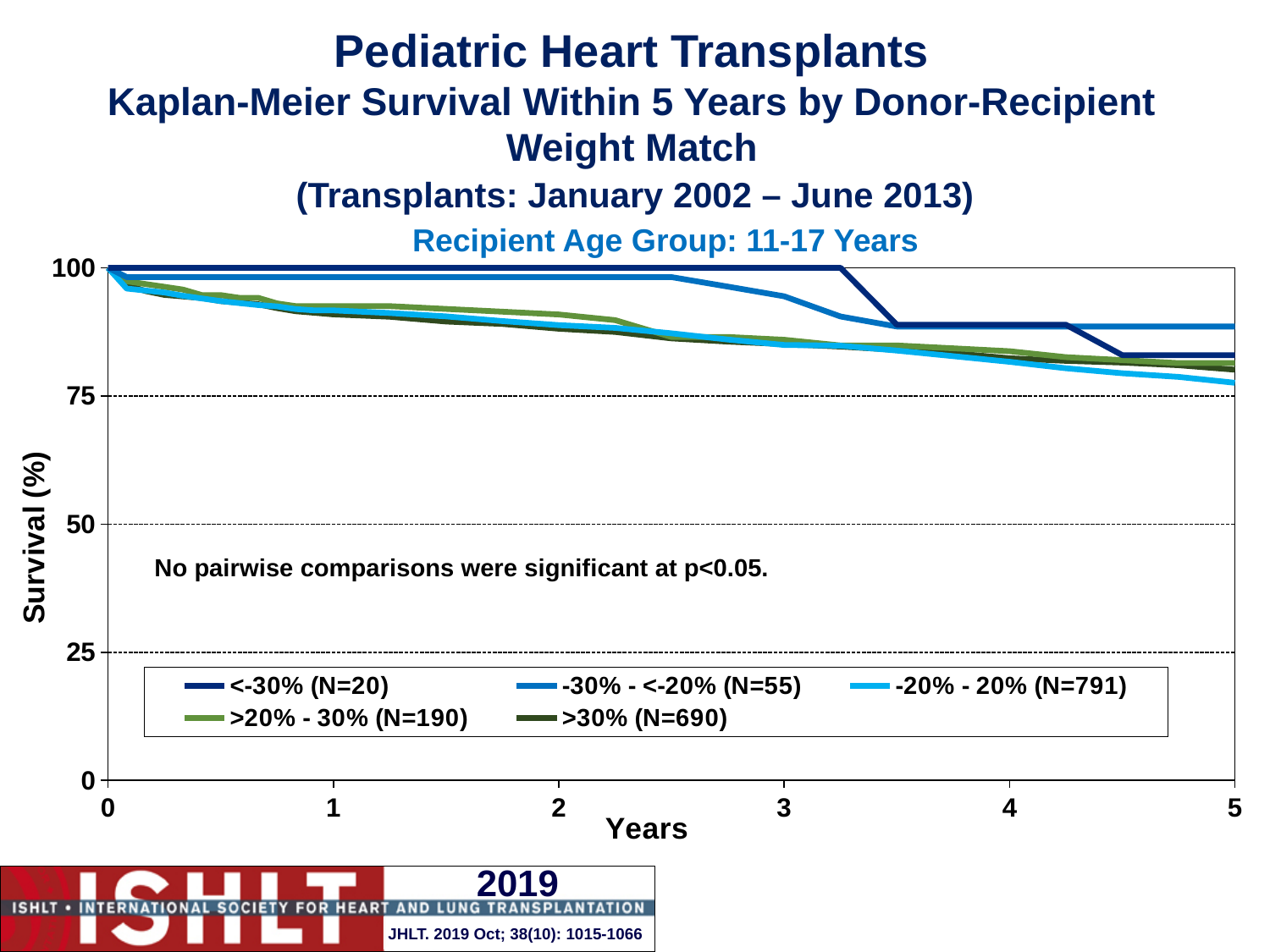
Which legend series has the largest number of patients (N)? -20% - 20% (N=791) At 3 years, which series has higher survival: <-30% (N=20) or >30% (N=690)? <-30% (N=20) Is the survival value for the -20% - 20% (N=791) series at 5 years greater or less than 75? greater Do the survival curves rise or fall as years increase along the x axis? Fall What kind of chart is shown on the slide? Line chart How many series does the legend list? 5 Is the survival value for the <-30% (N=20) series at 5 years greater or less than 75? greater Which recipient age group does the chart cover? 11-17 Years Is the survival value for the <-30% (N=20) series at 3 years greater or less than 75? greater At 5 years, which series has higher survival: -30% - <-20% (N=55) or -20% - 20% (N=791)? -30% - <-20% (N=55) Which series has the highest survival at 5 years? -30% - <-20% (N=55)